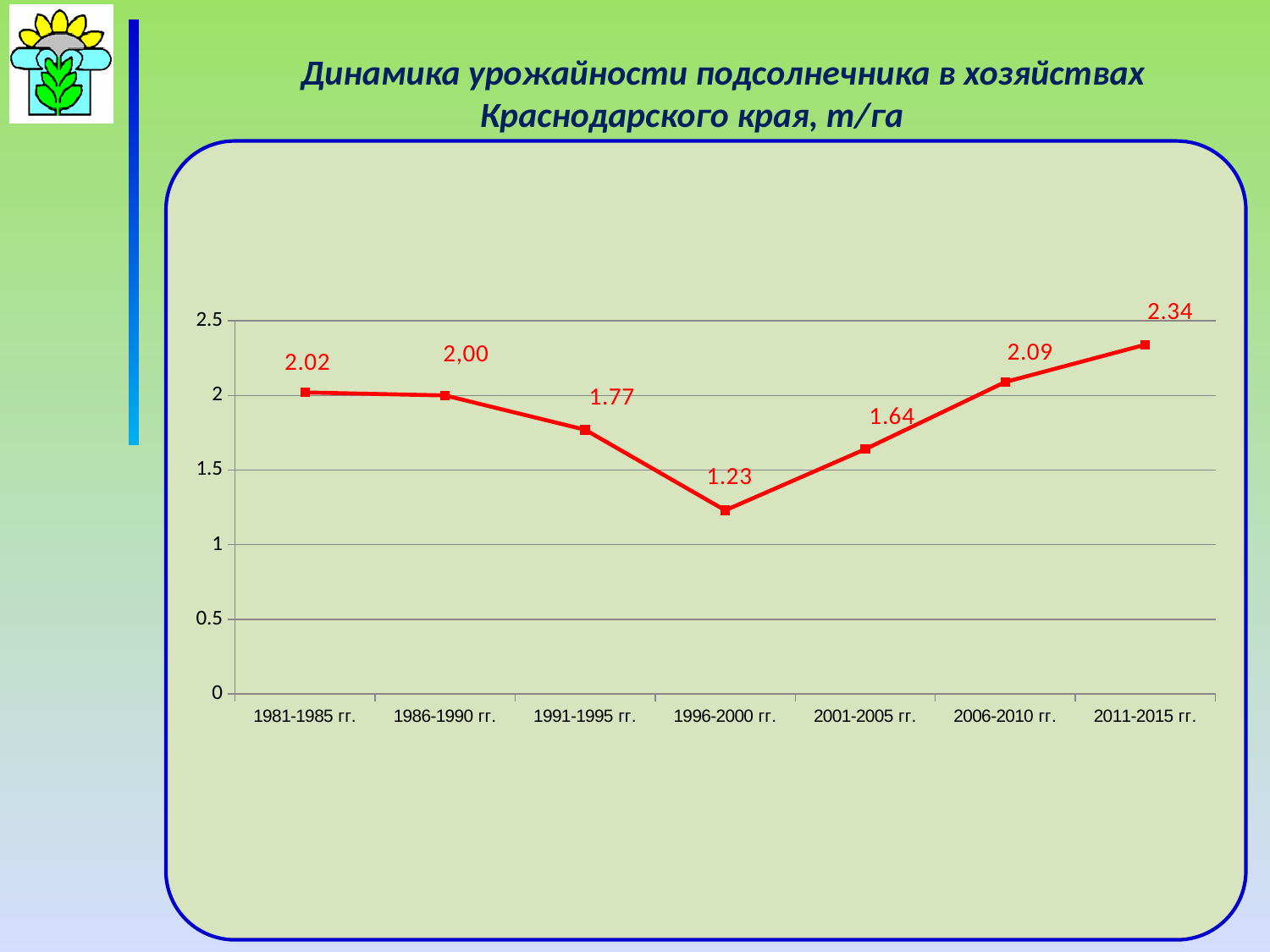
Which period has the highest yield? 2011-2015 гг. Is the value for 2006-2010 гг. greater or less than 2? greater Which period has the lowest yield? 1996-2000 гг. What kind of chart is shown on the slide? line chart What is the value shown for 1986-1990 гг.? 2,00 What is the value plotted for 2011-2015 гг.? 2.34 What colour is the plotted line? red How many periods are plotted on the x axis? 7 Do the values rise or fall from 1996-2000 гг. to 2011-2015 гг.? rise What is the sunflower yield for 1996-2000 гг.? 1.23 What is the difference between the values for 2011-2015 гг. and 1996-2000 гг.? 1.11 Which is larger, the value for 1991-1995 гг. or the value for 2001-2005 гг.? 1991-1995 гг.